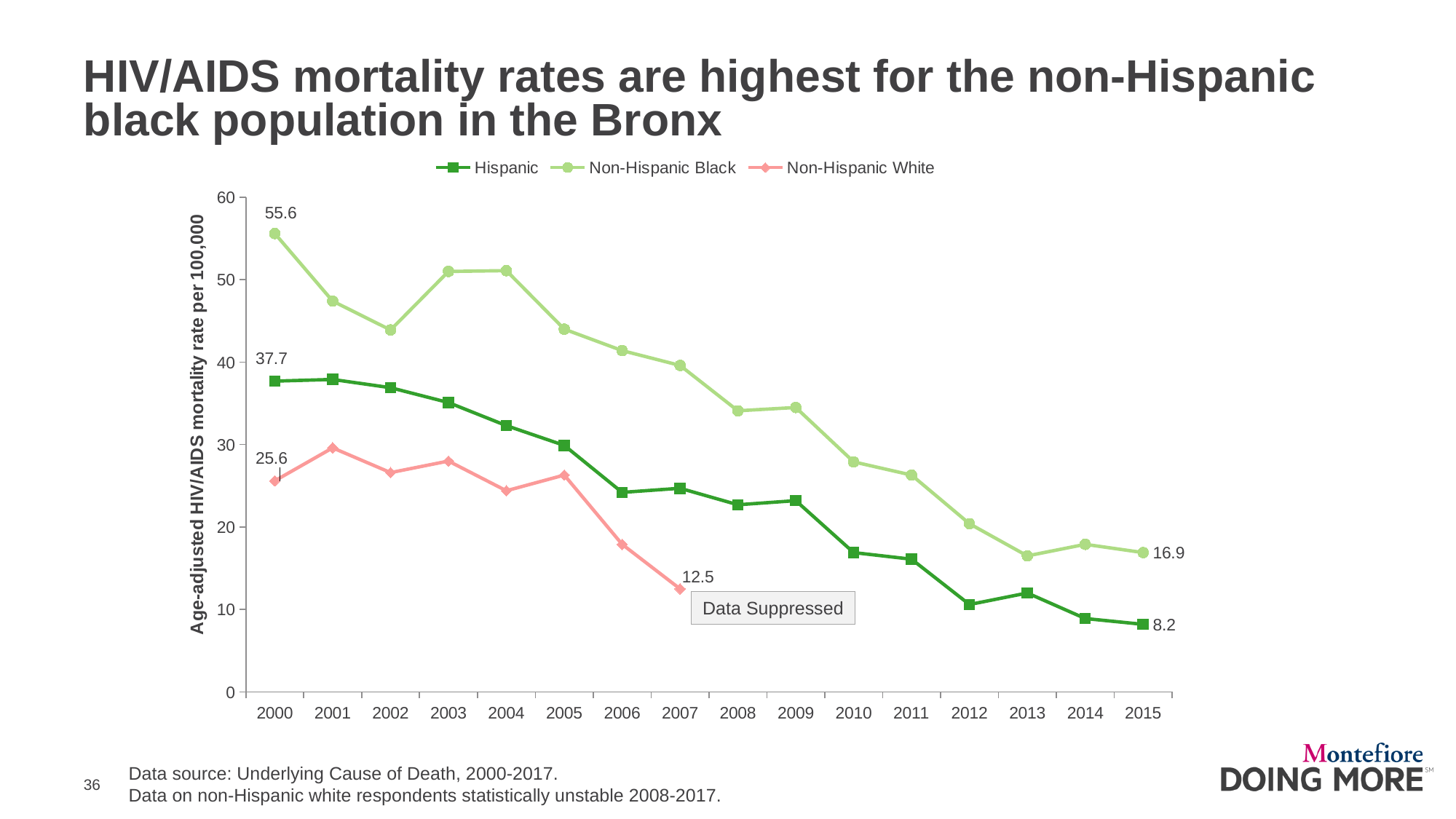
Is the Non-Hispanic Black mortality rate in 2003 greater or less than 50? greater How does the Hispanic mortality rate change from 2000 to 2015? It falls How many years are shown on the x axis? 16 What was the HIV/AIDS mortality rate for the Hispanic population in 2015? 8.2 What was the HIV/AIDS mortality rate for the Non-Hispanic White population in 2007? 12.5 Which series had the highest mortality rate in 2000? Non-Hispanic Black What was the HIV/AIDS mortality rate for the Hispanic population in 2000? 37.7 What was the HIV/AIDS mortality rate for the Non-Hispanic Black population in 2000? 55.6 What type of chart is shown on the slide? line chart What is the difference between the Non-Hispanic Black rate in 2000 and in 2015? 38.7 How many series does the legend list? 3 What was the HIV/AIDS mortality rate for the Non-Hispanic White population in 2000? 25.6